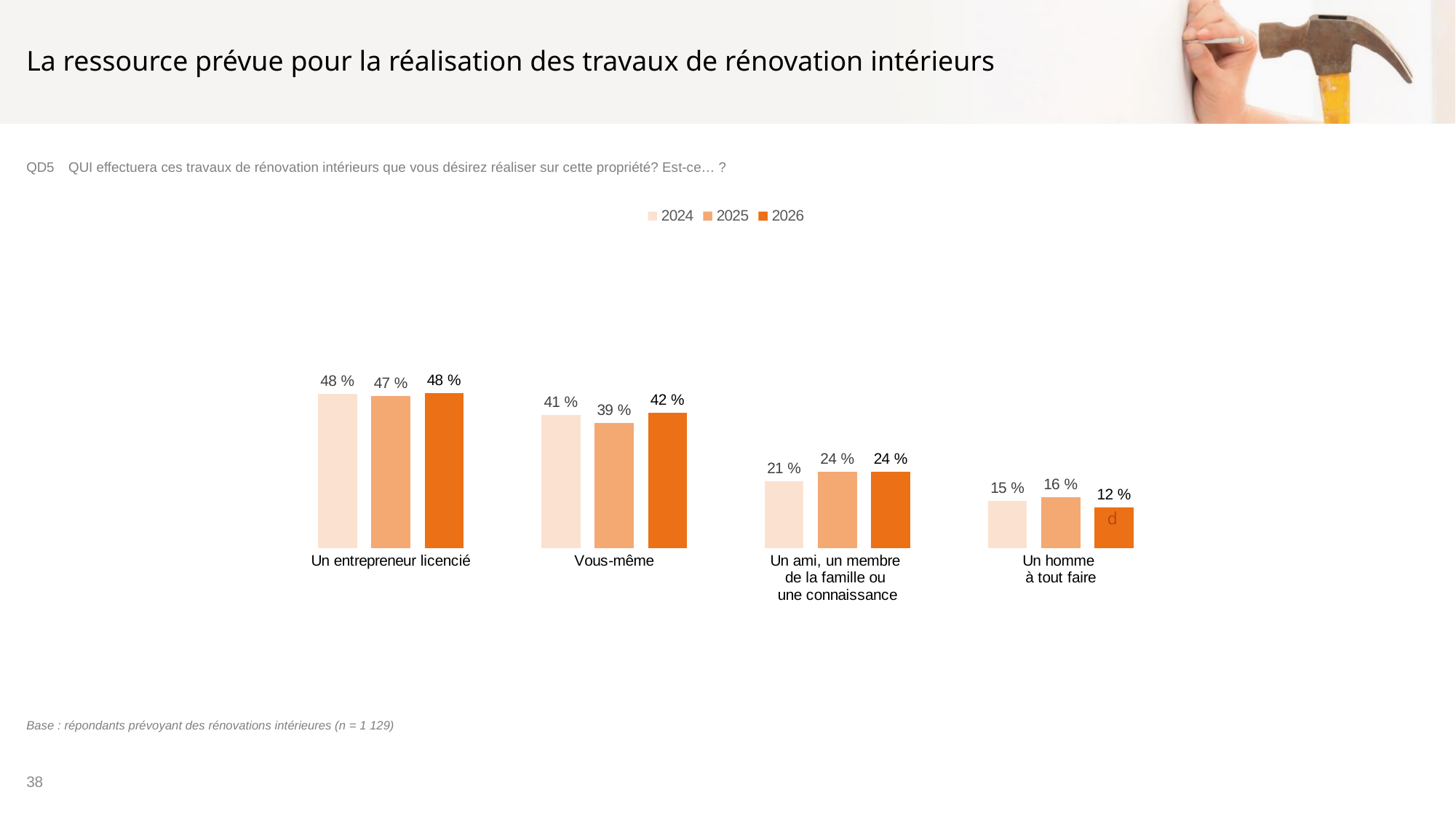
Which series is shown in the darkest orange colour? 2026 What is the value for "Vous-même" in 2025? 39 % What is the value for "Un ami, un membre de la famille ou une connaissance" in 2024? 21 % Which is larger for "Un homme à tout faire": the 2025 value or the 2026 value? 2025 How many categories are shown on the x axis? 4 What is the value for "Un entrepreneur licencié" in 2026? 48 % What is the difference between the 2026 and 2025 values for "Vous-même"? 3 % Which category has the highest value in 2026? Un entrepreneur licencié What is the value for "Un homme à tout faire" in 2024? 15 % Which category has the lowest value in 2025? Un homme à tout faire What kind of chart is shown on the slide? Bar chart How many series does the legend list? 3